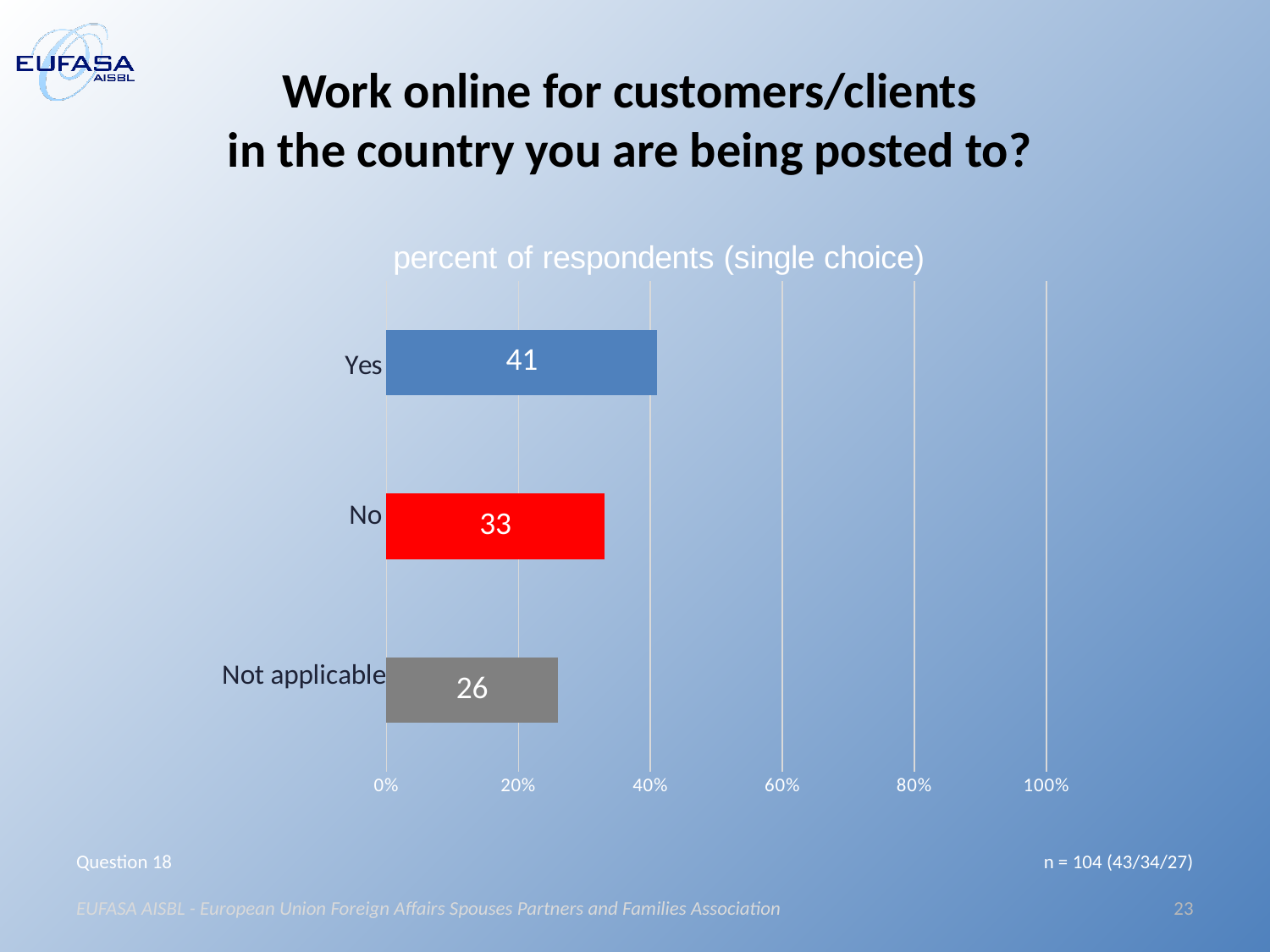
Which category has the lowest value? Not applicable Which is larger, the value for No or the value for Not applicable? No What is the value for No? 33 How many categories are shown in the chart? 3 What is the value for Yes? 41 What kind of chart is shown on the slide? bar chart What is the difference between the values for Yes and No? 8 What is the title of the chart? percent of respondents (single choice) What is the value for Not applicable? 26 What is the difference between the values for No and Not applicable? 7 Which category has the highest value? Yes Is the value for Yes greater or less than 60%? less